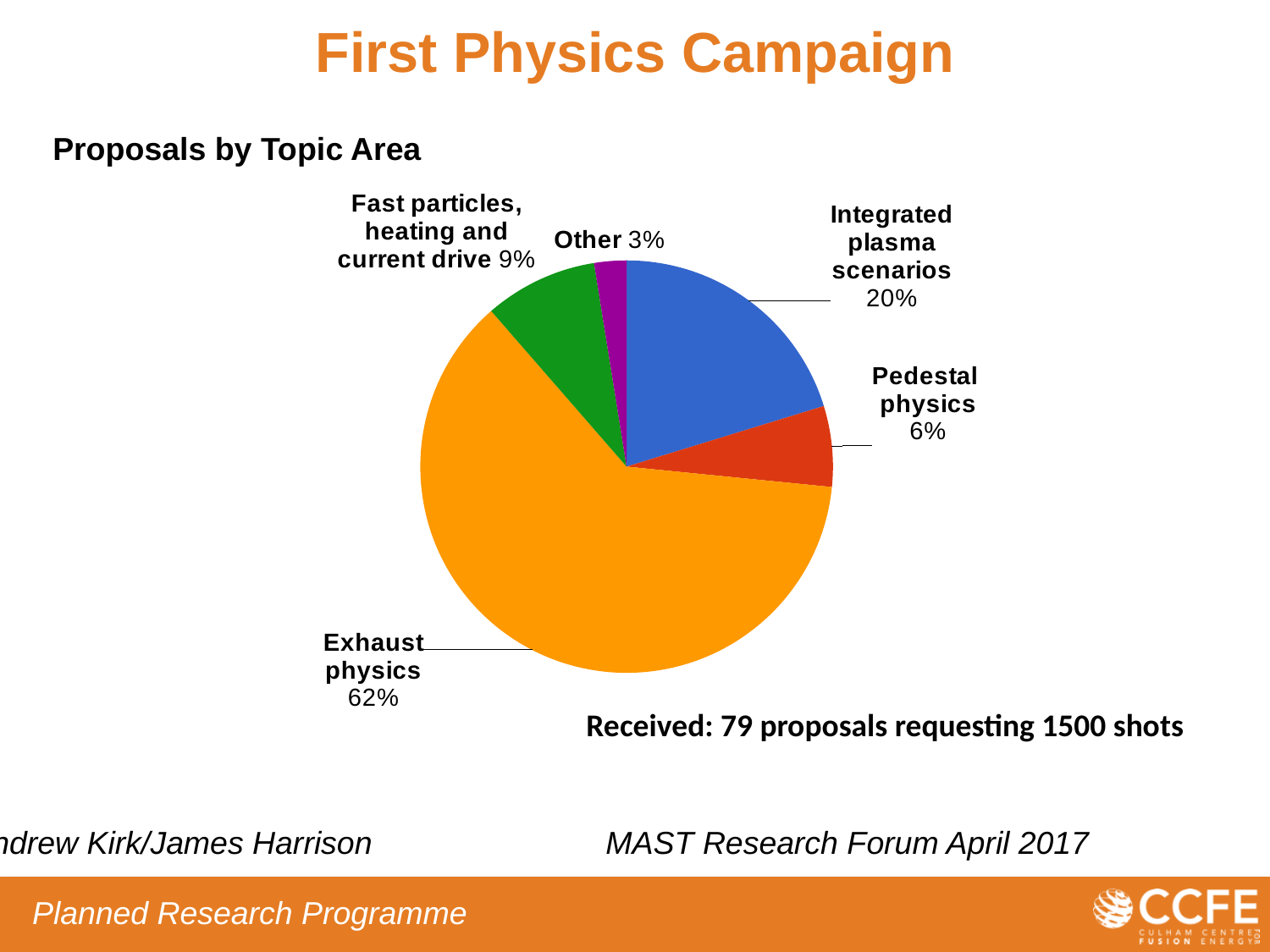
What kind of chart is shown on the slide? pie chart What is the difference in percentage points between Exhaust physics and Integrated plasma scenarios? 42 What colour is the Exhaust physics slice? orange Which topic area has the largest share of proposals? Exhaust physics How many topic areas are shown in the pie chart? 5 What share of proposals is for Integrated plasma scenarios? 20% What share of proposals is for Exhaust physics? 62% What share of proposals is for Fast particles, heating and current drive? 9% Which topic area has the smallest share of proposals? Other Which has a larger share, Pedestal physics or Fast particles, heating and current drive? Fast particles, heating and current drive